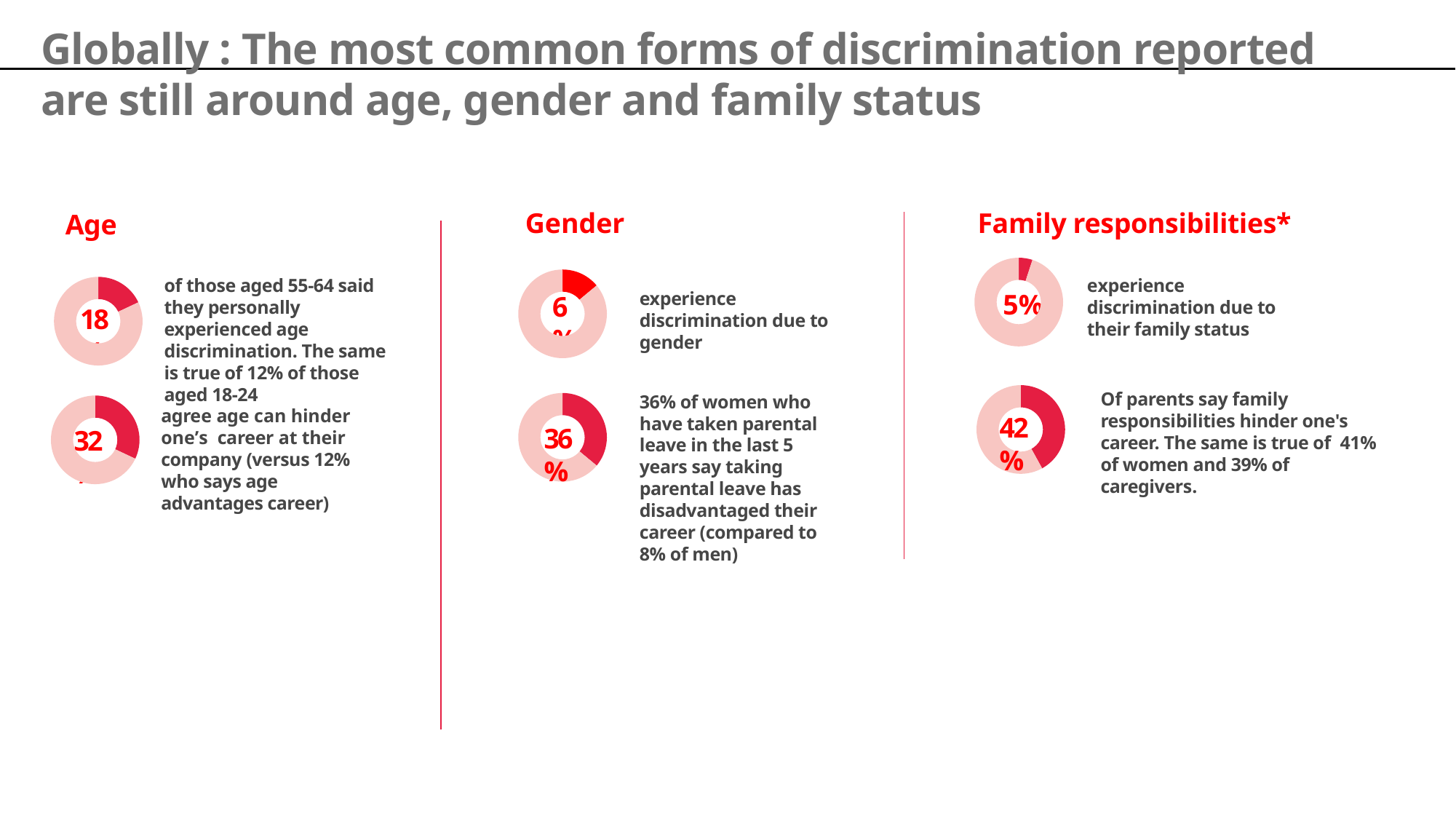
In the Gender section, what value is shown in the centre of the bottom donut chart? 36% In the Age section, what number is shown in the centre of the bottom donut chart? 32 In the Family responsibilities section, what value is shown in the centre of the top donut chart? 5% Which donut chart on the slide shows the highest value? the bottom Family responsibilities chart (42%) How many donut charts are shown on the slide? 6 In the Family responsibilities section, what value is shown in the centre of the bottom donut chart? 42% In the Gender section, what number is shown in the centre of the top donut chart? 6 In the Age section, what number is shown in the centre of the top donut chart? 18 What is the difference between the values of the bottom Family responsibilities donut chart and the bottom Gender donut chart? 6% Which is larger: the value in the bottom Gender donut chart or the value in the bottom Family responsibilities donut chart? the bottom Family responsibilities chart (42%) Which donut chart on the slide shows the lowest value? the top Family responsibilities chart (5%) What type of chart is used in the Age section of the slide? donut chart